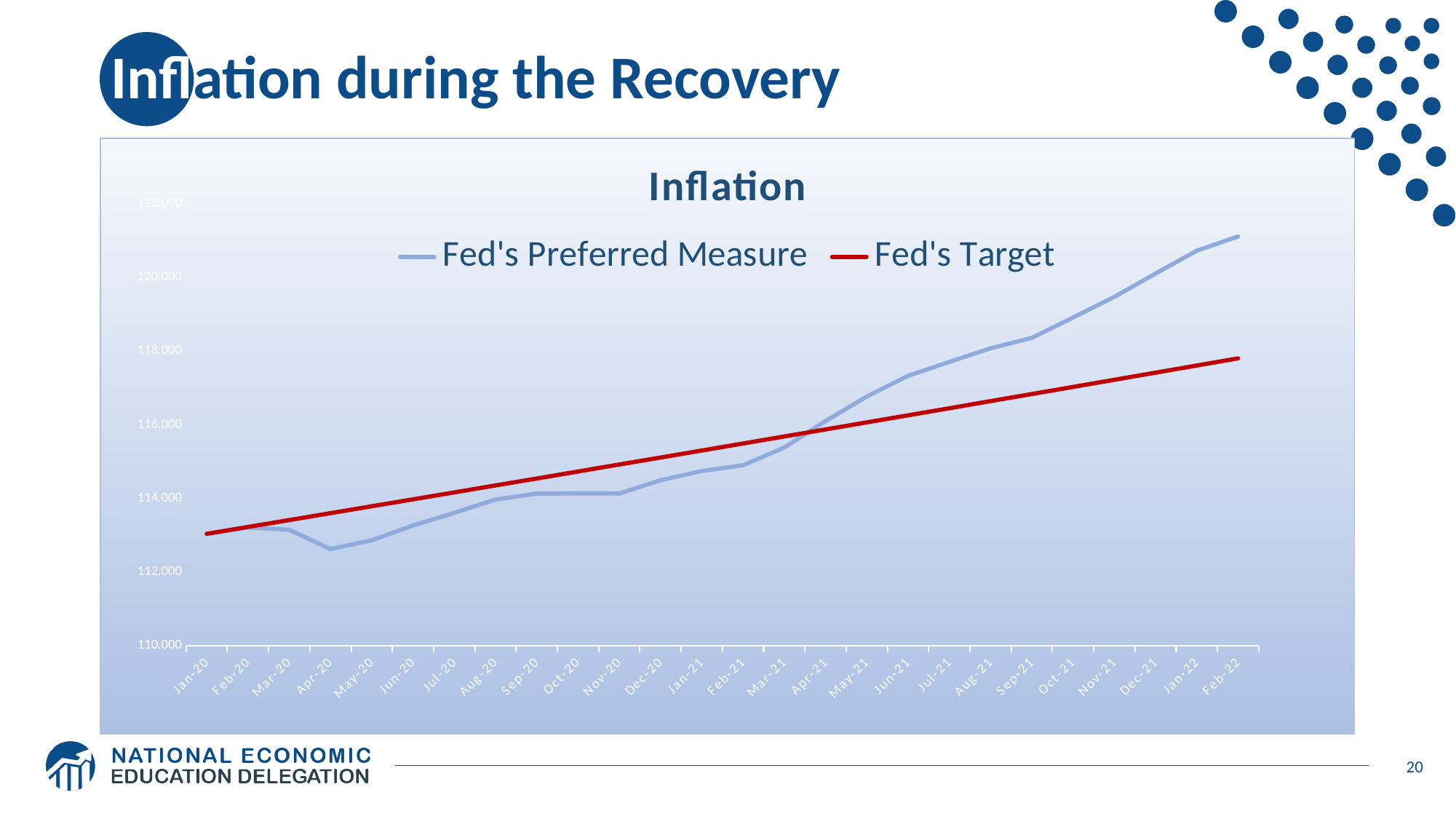
Is the value of Fed's Preferred Measure in Feb-22 greater or less than 120.000? greater Is the value of Fed's Target in Feb-22 greater or less than 118.000? less In Apr-20, which series has the higher value, Fed's Preferred Measure or Fed's Target? Fed's Target What are the two series named in the legend? Fed's Preferred Measure and Fed's Target In Feb-22, which series has the higher value, Fed's Preferred Measure or Fed's Target? Fed's Preferred Measure What is the title of the chart? Inflation In which month does Fed's Preferred Measure reach its lowest value? Apr-20 How many months are shown along the x axis? 26 Is the value of Fed's Preferred Measure in Apr-20 greater or less than 112.000? greater What kind of chart is shown on the slide? line chart How many series does the legend list? 2